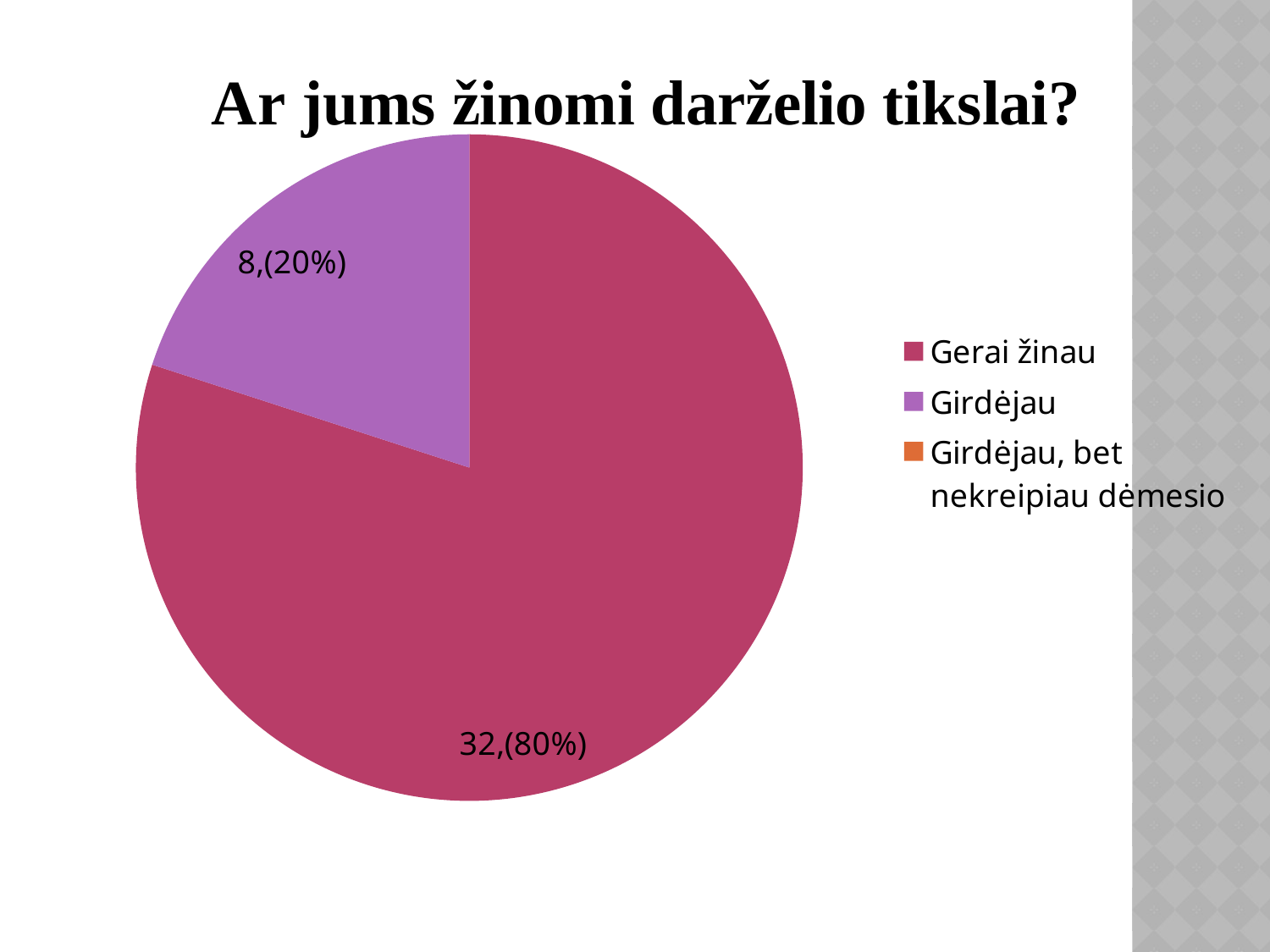
What kind of chart is shown on the slide? pie chart What share of the pie does the 'Girdėjau' slice represent? 20% Which category has the largest slice of the pie? Gerai žinau What is the difference in count between the 'Gerai žinau' and 'Girdėjau' slices? 24 What colour is the 'Girdėjau' slice? purple What is the data label shown on the 'Gerai žinau' slice? 32,(80%) What is the data label shown on the 'Girdėjau' slice? 8,(20%) What is the title of the chart? Ar jums žinomi darželio tikslai? Which is larger, the 'Girdėjau' slice or the 'Gerai žinau' slice? Gerai žinau How many entries does the legend list? 3 What share of the pie does the 'Gerai žinau' slice represent? 80% Which of the two visible slices is smaller, 'Gerai žinau' or 'Girdėjau'? Girdėjau